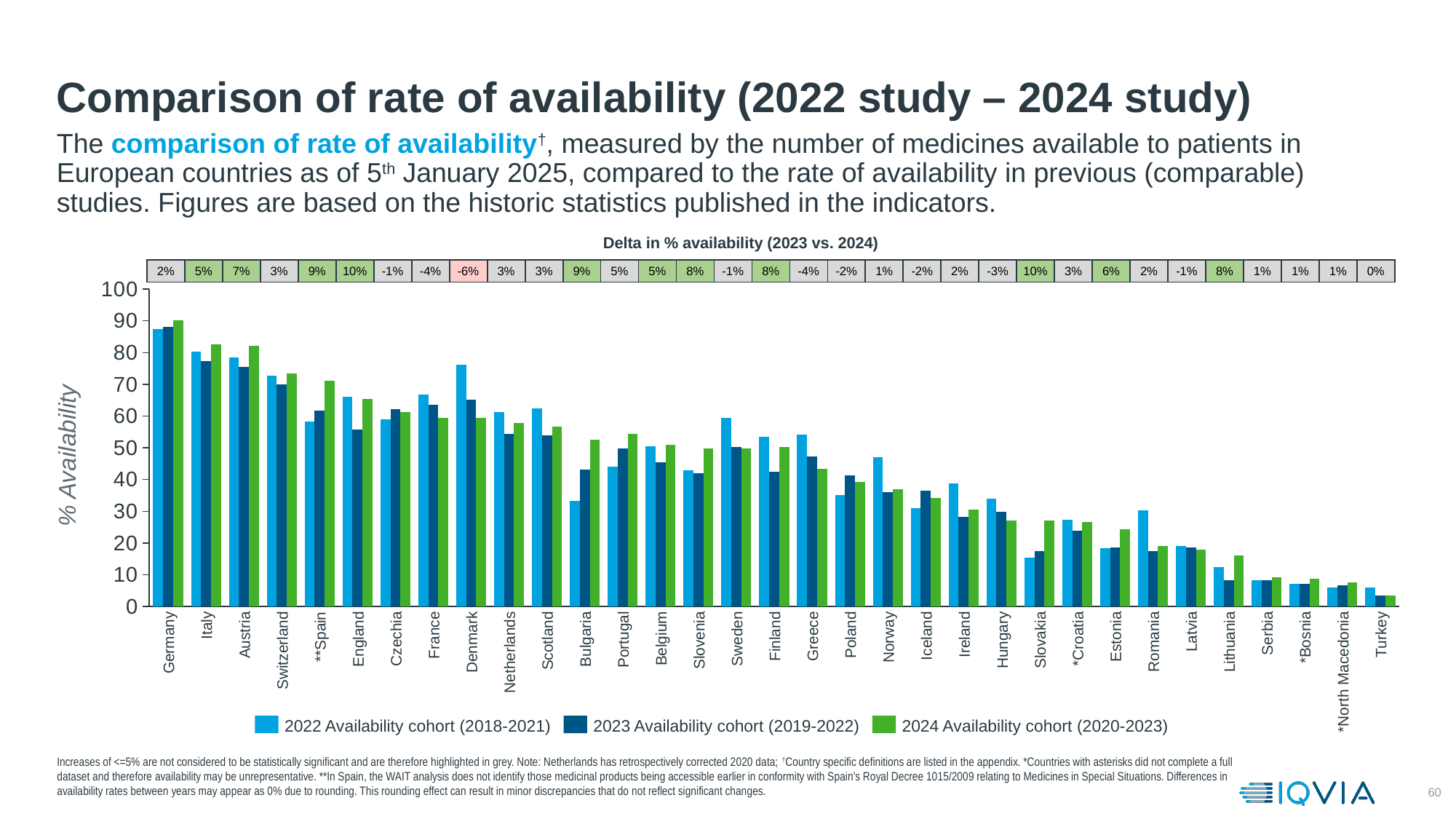
What is the delta in % availability (2023 vs. 2024) shown for Germany? 2% What is the delta in % availability (2023 vs. 2024) shown for Denmark? -6% Do the % Availability values generally rise or fall moving from left to right along the x axis? fall What is the delta in % availability (2023 vs. 2024) shown for Turkey? 0% What kind of chart is shown on the slide? bar chart How many series does the legend list? 3 For Denmark, which is larger: the 2022 Availability cohort (2018-2021) value or the 2024 Availability cohort (2020-2023) value? 2022 Availability cohort (2018-2021) Is the 2024 Availability cohort (2020-2023) value for Germany greater or less than 80? greater Which country has the highest 2024 Availability cohort (2020-2023) value? Germany How many countries are shown on the x axis of the chart? 33 Which country has the lowest 2024 Availability cohort (2020-2023) value? Turkey What is the delta in % availability (2023 vs. 2024) shown for Slovakia? 10%